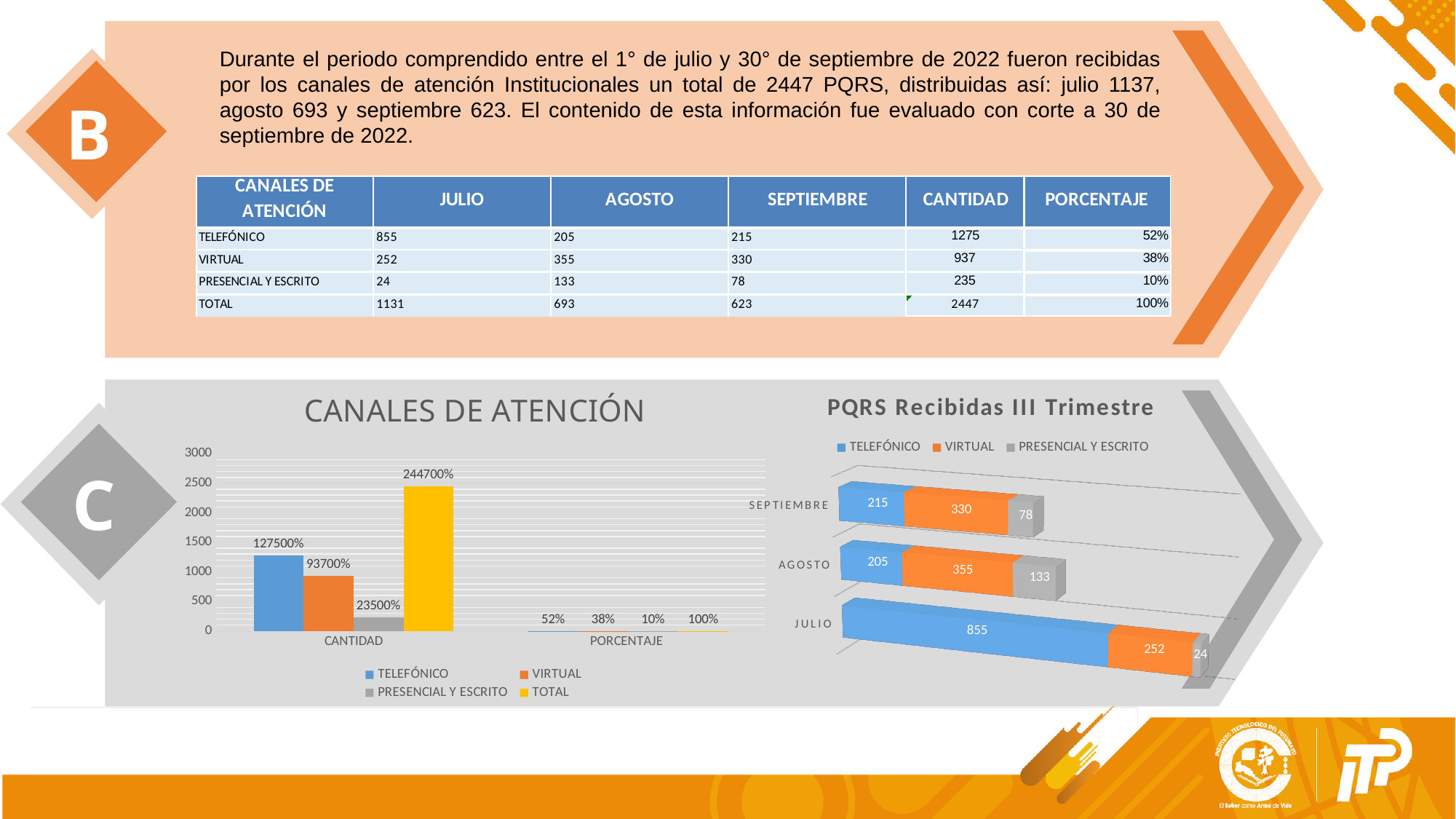
In the 'PQRS Recibidas III Trimestre' chart, what is the total of the stacked bar for SEPTIEMBRE? 623 In the 'CANALES DE ATENCIÓN' chart, what is the data label on the TOTAL bar for CANTIDAD? 244700% In the 'PQRS Recibidas III Trimestre' chart, what is the PRESENCIAL Y ESCRITO value for SEPTIEMBRE? 78 In the 'PQRS Recibidas III Trimestre' chart, what is the TELEFÓNICO value for JULIO? 855 In the 'CANALES DE ATENCIÓN' chart, what is the data label on the VIRTUAL bar for PORCENTAJE? 38% What kind of chart is 'CANALES DE ATENCIÓN'? Bar chart In the 'CANALES DE ATENCIÓN' chart, how many series does the legend list? 4 In the 'PQRS Recibidas III Trimestre' chart, which month has the highest TELEFÓNICO value? JULIO In the 'PQRS Recibidas III Trimestre' chart, how many series does the legend list? 3 In the 'PQRS Recibidas III Trimestre' chart, what is the VIRTUAL value for AGOSTO? 355 In the 'PQRS Recibidas III Trimestre' chart, what is the difference between the VIRTUAL values for AGOSTO and SEPTIEMBRE? 25 In the 'PQRS Recibidas III Trimestre' chart, what is the total of the stacked bar for JULIO? 1131